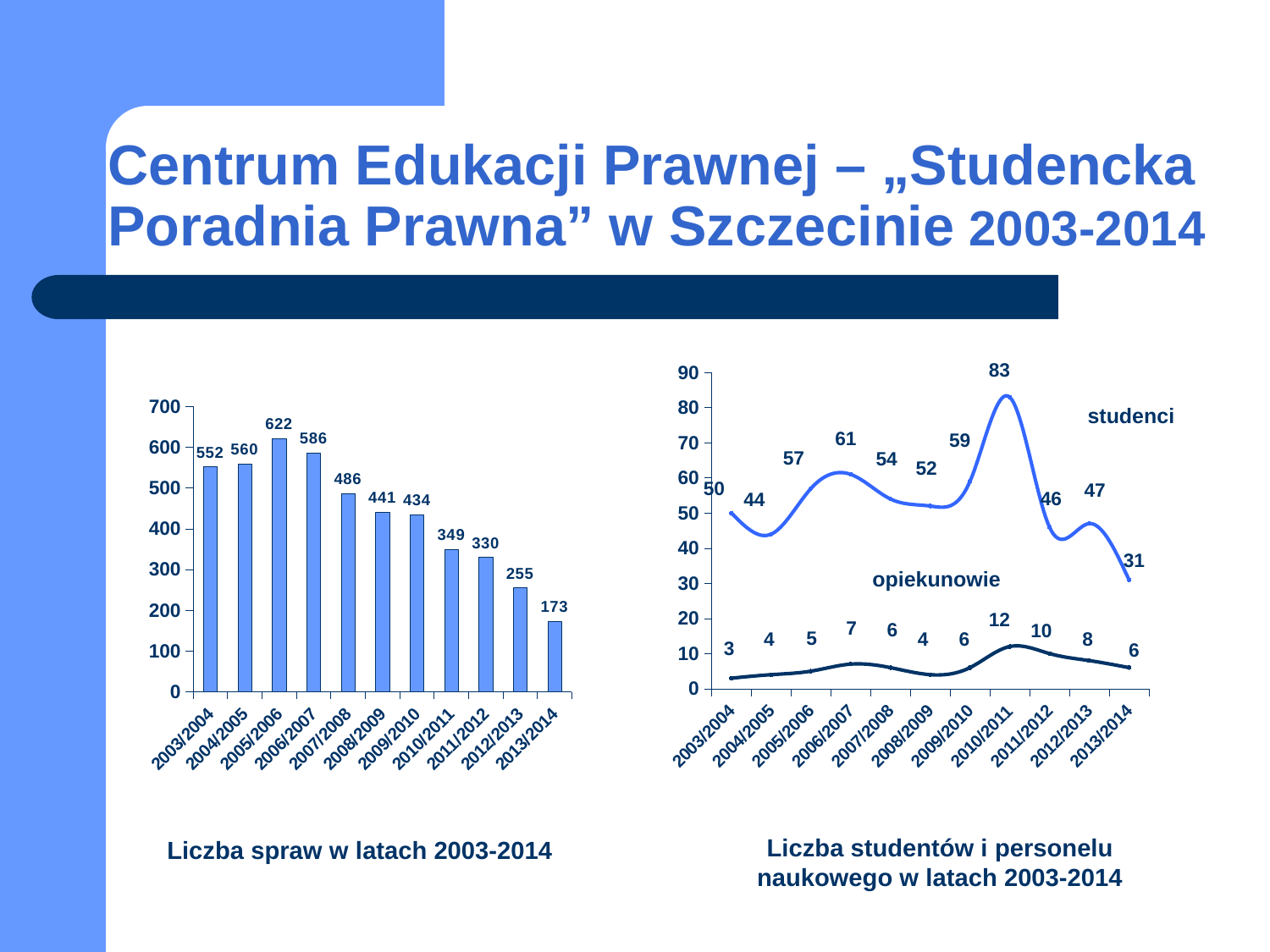
In the left chart (Liczba spraw w latach 2003-2014), how many years are shown on the x axis? 11 What kind of chart is the right chart (Liczba studentów i personelu naukowego)? line chart In the left chart (Liczba spraw w latach 2003-2014), do the values generally rise or fall from 2006/2007 to 2013/2014? fall In the right chart (Liczba studentów i personelu naukowego), which year has the lowest value for studenci? 2013/2014 What kind of chart is the left chart (Liczba spraw w latach 2003-2014)? bar chart In the left chart (Liczba spraw w latach 2003-2014), what is the value for 2005/2006? 622 In the left chart (Liczba spraw w latach 2003-2014), what is the difference between the values for 2003/2004 and 2013/2014? 379 In the left chart (Liczba spraw w latach 2003-2014), which year has the lowest value? 2013/2014 In the left chart (Liczba spraw w latach 2003-2014), which year has the highest value? 2005/2006 In the right chart (Liczba studentów i personelu naukowego), what is the difference between studenci and opiekunowie in 2010/2011? 71 In the right chart (Liczba studentów i personelu naukowego), what is the value for opiekunowie in 2011/2012? 10 In the right chart (Liczba studentów i personelu naukowego), what is the value for studenci in 2010/2011? 83